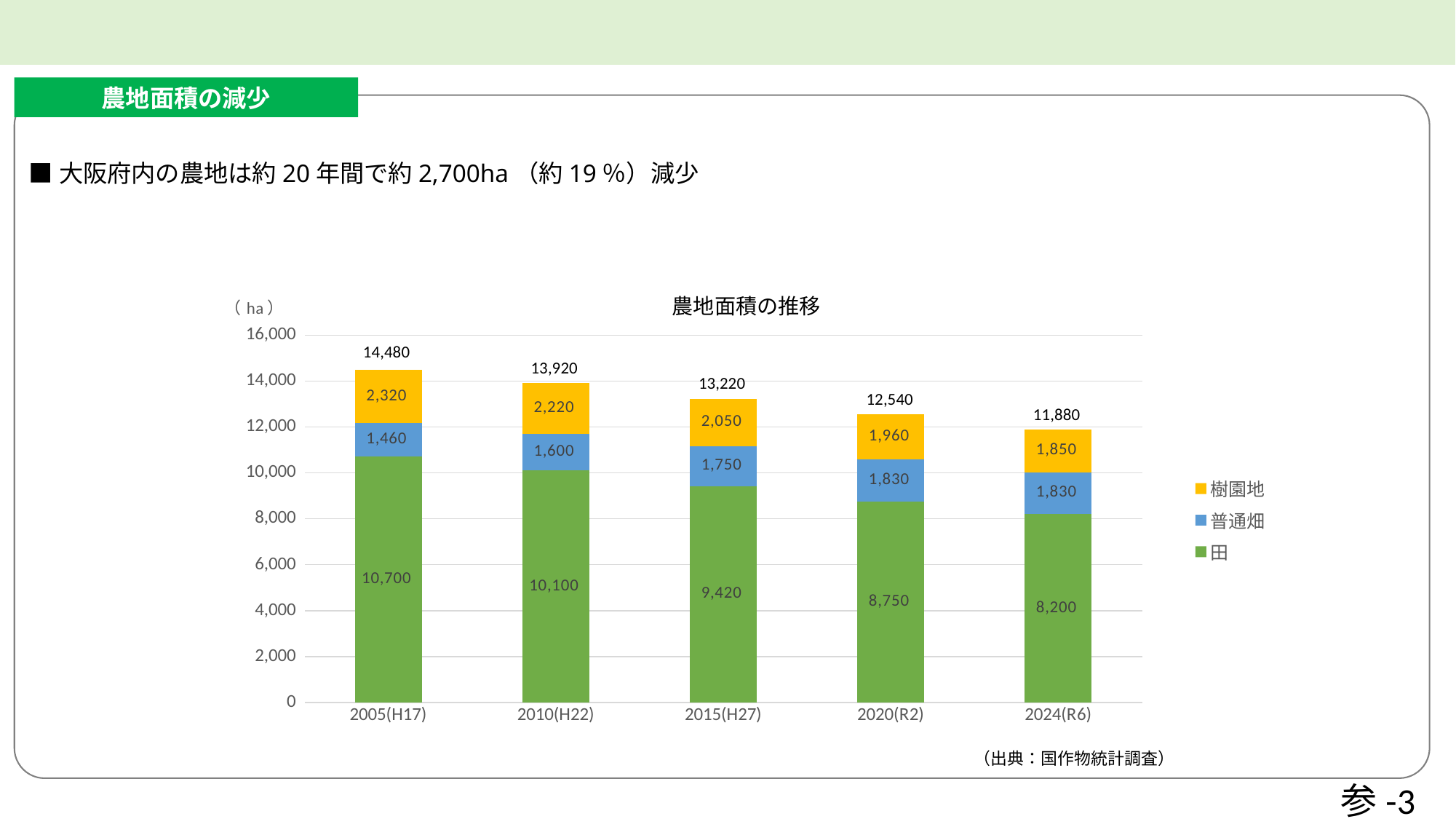
How many year categories are shown on the x axis? 5 What is the title of the chart? 農地面積の推移 Which year has the highest total farmland area? 2005(H17) What is the difference between the total for 2005(H17) and the total for 2024(R6)? 2,600 Do the total values rise or fall from 2005(H17) to 2024(R6)? Fall Which year has the lowest value for 田? 2024(R6) How many series does the legend list? 3 What is the value of 田 for 2005(H17)? 10,700 What is the value of 普通畑 for 2024(R6)? 1,830 What is the value of 樹園地 for 2015(H27)? 2,050 What is the total of the stacked bar for 2020(R2)? 12,540 What kind of chart is shown on the slide? Stacked bar chart